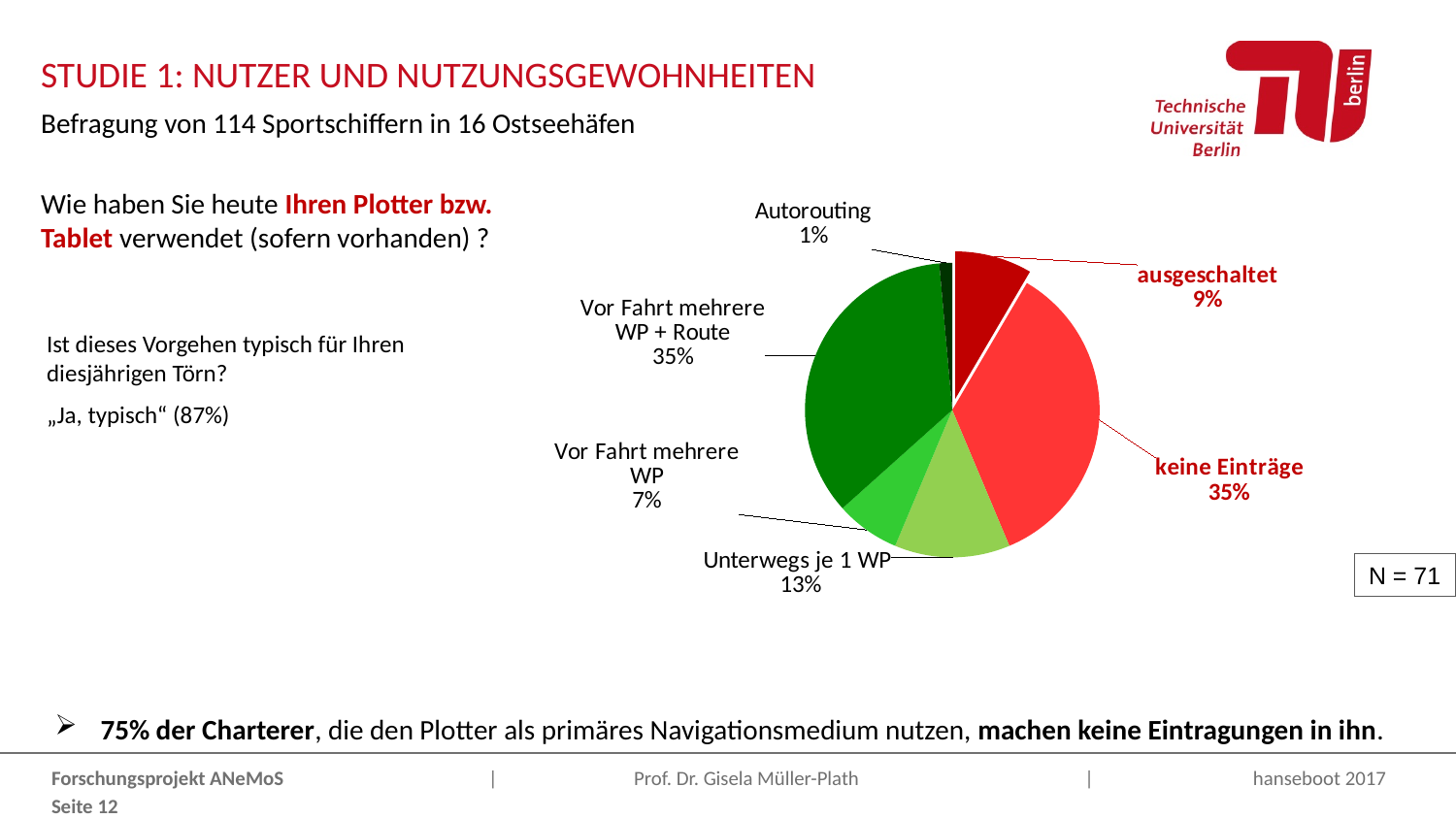
What share of the pie does "Vor Fahrt mehrere WP" have? 7% Which is larger, "Unterwegs je 1 WP" or "Vor Fahrt mehrere WP"? Unterwegs je 1 WP What kind of chart is shown on the slide? pie chart Which slice of the pie is the smallest? Autorouting What is the combined share of "ausgeschaltet" and "keine Einträge"? 44% What sample size (N) is shown next to the pie chart? N = 71 What share of the pie does "keine Einträge" have? 35% What share of the pie does "ausgeschaltet" have? 9% What is the difference in percentage points between "keine Einträge" and "ausgeschaltet"? 26 What share of the pie does "Unterwegs je 1 WP" have? 13% What share of the pie does "Vor Fahrt mehrere WP + Route" have? 35% How many slices does the pie chart have? 6